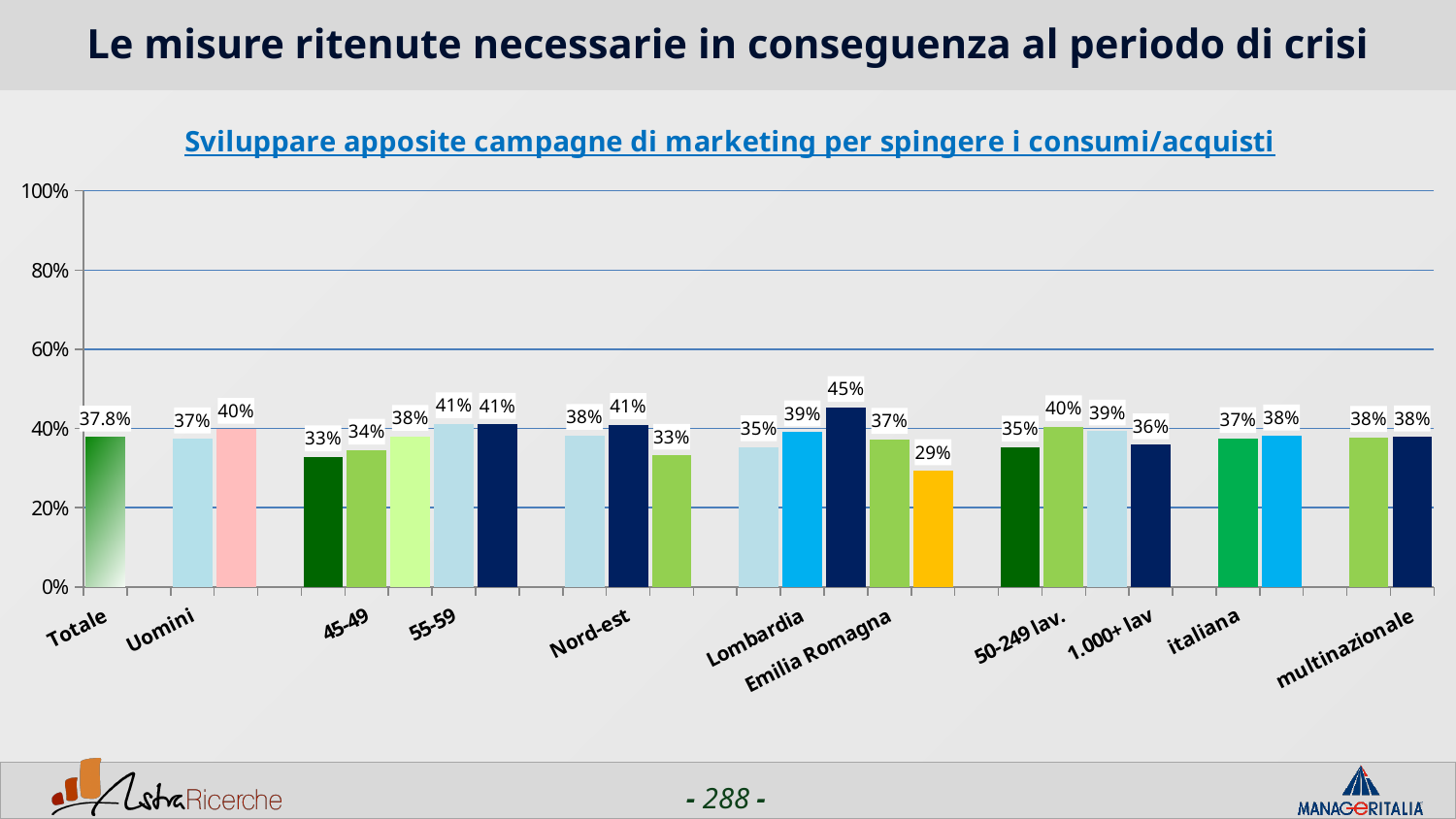
What is the value for Totale? 37.8% What is the value for Lombardia? 39% What is the value for multinazionale? 38% What kind of chart is shown on the slide? bar chart How many bars are plotted in the chart? 24 Is the value for Totale greater or less than 40%? less What is the value for 1.000+ lav? 36% What is the title of the chart? Sviluppare apposite campagne di marketing per spingere i consumi/acquisti What is the value for Uomini? 37% What is the value for Nord-est? 41% Which is larger, the value for Nord-est or the value for Uomini? Nord-est What is the difference between the value for Nord-est and the value for Uomini? 4 percentage points